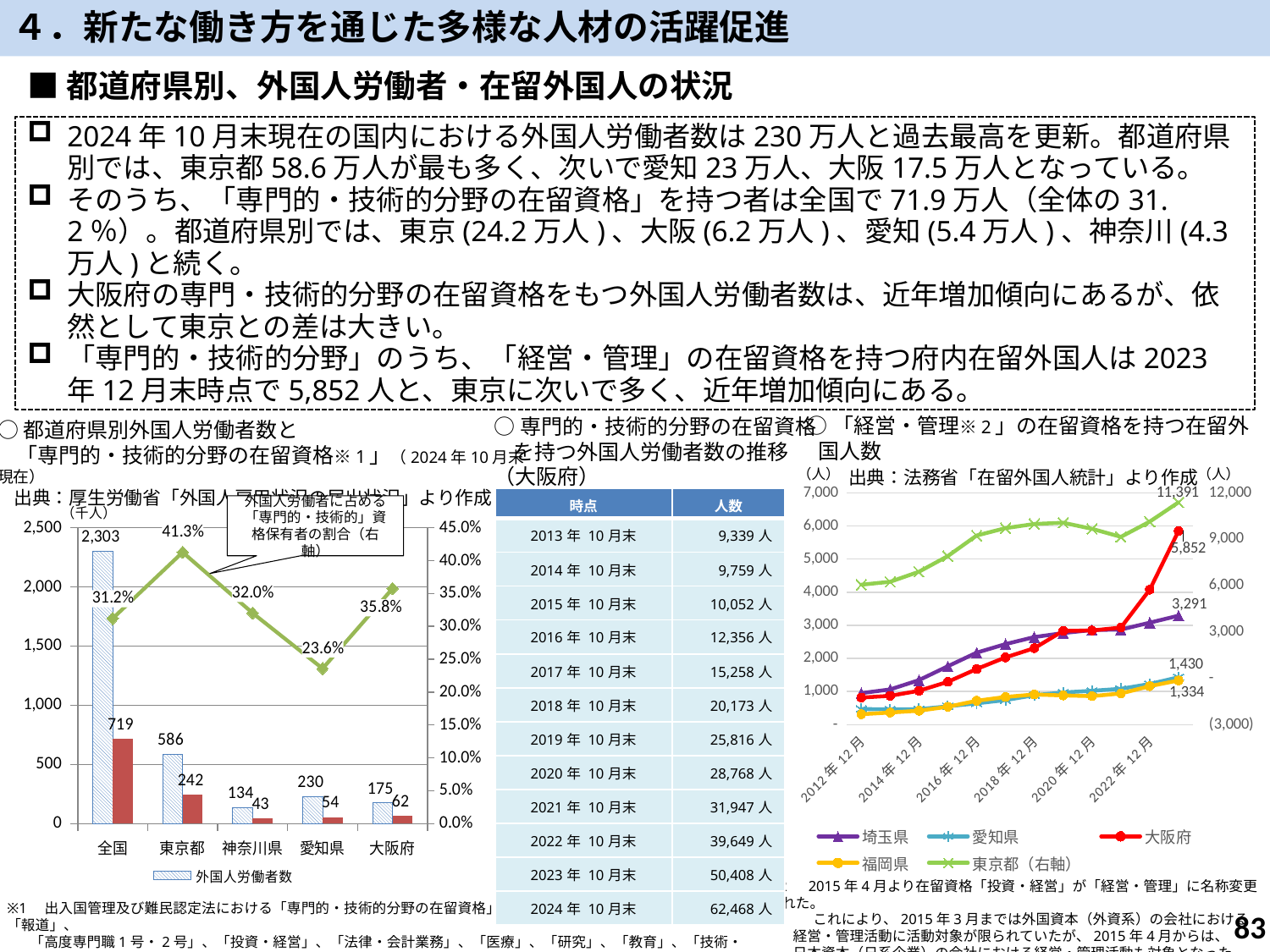
How many categories are shown on the x axis of the left chart? 5 In the left chart, which prefecture has the highest percentage on the line series? 東京都 In the left chart (都道府県別外国人労働者数), what is the number of 外国人労働者数 (in thousands) for 東京都? 586 How many series does the legend of the right chart (「経営・管理」の在留資格を持つ在留外国人数) list? 5 In the right chart, does the 大阪府 line rise or fall over time? Rise In the left chart, what is the difference between the red bar values for 東京都 (242) and 大阪府 (62)? 180 In the left chart, what is the value of the red bar (専門的・技術的分野の在留資格) for 大阪府? 62 In the left chart, what percentage does the line show for 東京都? 41.3% In the right chart, what is the latest labelled value for 東京都 (右軸)? 11,391 In the right chart, what is the latest labelled value for 大阪府? 5,852 In the left chart, which category has the lowest percentage on the line series? 愛知県 What kind of chart is the left chart? A bar chart combined with a line chart